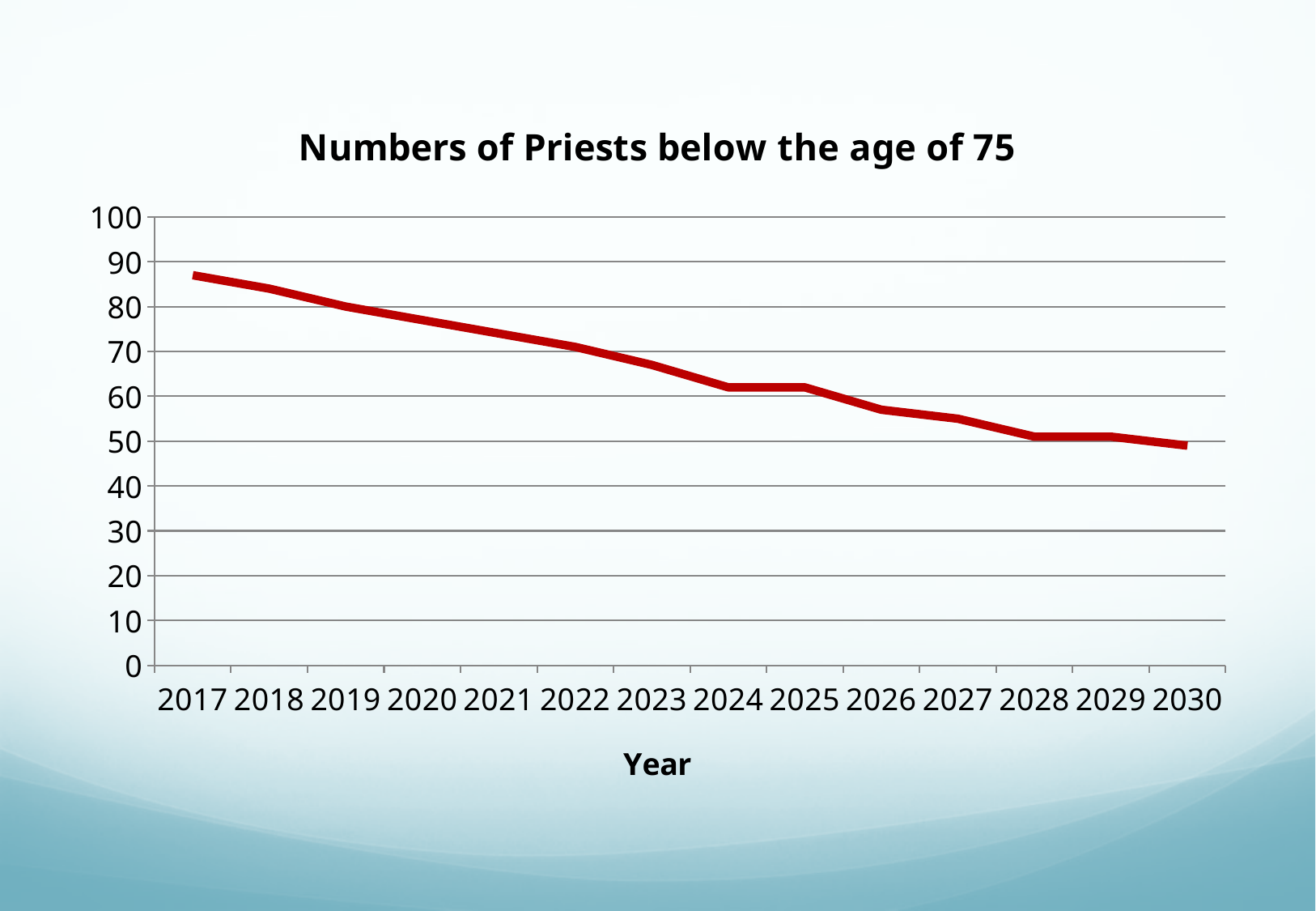
How many years are plotted along the x axis? 14 Is the value for 2017 greater or less than 80? greater What kind of chart is shown on the slide? line chart Is the value for 2024 greater or less than 70? less Which is larger, the value for 2019 or the value for 2027? 2019 What is the title of the chart? Numbers of Priests below the age of 75 Do the values rise or fall from 2017 to 2030? fall Is the value for 2028 greater or less than 60? less Which year has the lowest number of priests below the age of 75? 2030 Which year has the highest number of priests below the age of 75? 2017 What is the label of the x axis? Year